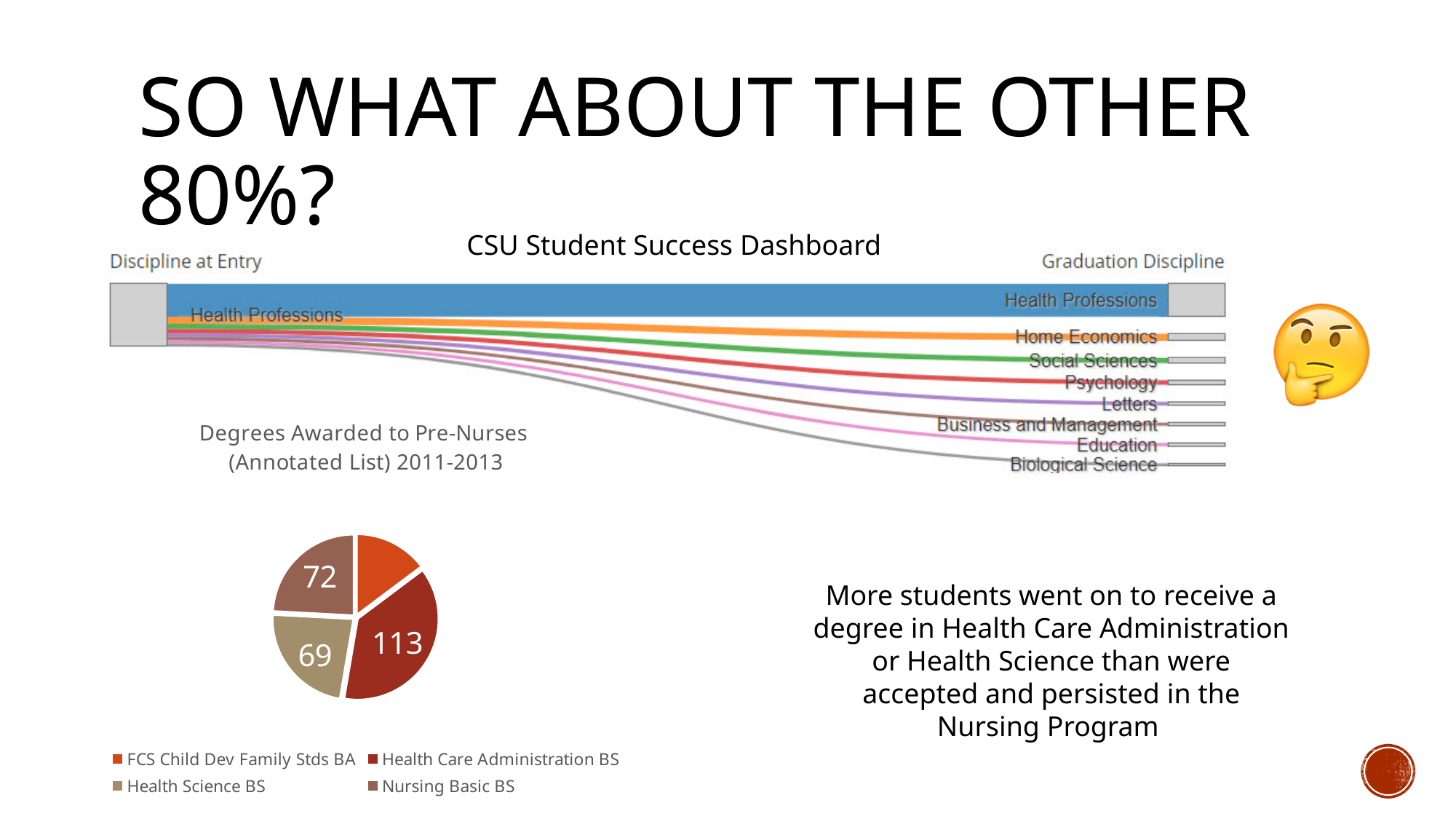
In the pie chart 'Degrees Awarded to Pre-Nurses (Annotated List) 2011-2013', which category has the smallest slice? FCS Child Dev Family Stds BA In the 'CSU Student Success Dashboard' chart at the top of the slide, what is the discipline at entry? Health Professions How many slices does the pie chart 'Degrees Awarded to Pre-Nurses (Annotated List) 2011-2013' have? 4 In the pie chart 'Degrees Awarded to Pre-Nurses (Annotated List) 2011-2013', which category has the largest slice? Health Care Administration BS In the pie chart 'Degrees Awarded to Pre-Nurses (Annotated List) 2011-2013', which is larger: Nursing Basic BS or Health Science BS? Nursing Basic BS In the pie chart 'Degrees Awarded to Pre-Nurses (Annotated List) 2011-2013', what is the difference between the values for Health Care Administration BS and Health Science BS? 44 In the 'CSU Student Success Dashboard' chart at the top of the slide, how many graduation disciplines are listed on the right side? 8 In the pie chart 'Degrees Awarded to Pre-Nurses (Annotated List) 2011-2013', what value is shown for Health Care Administration BS? 113 What kind of chart is the 'Degrees Awarded to Pre-Nurses (Annotated List) 2011-2013' chart? Pie chart How many entries does the legend of the pie chart 'Degrees Awarded to Pre-Nurses (Annotated List) 2011-2013' list? 4 In the pie chart 'Degrees Awarded to Pre-Nurses (Annotated List) 2011-2013', what value is shown for Health Science BS? 69 In the pie chart 'Degrees Awarded to Pre-Nurses (Annotated List) 2011-2013', what value is shown for Nursing Basic BS? 72